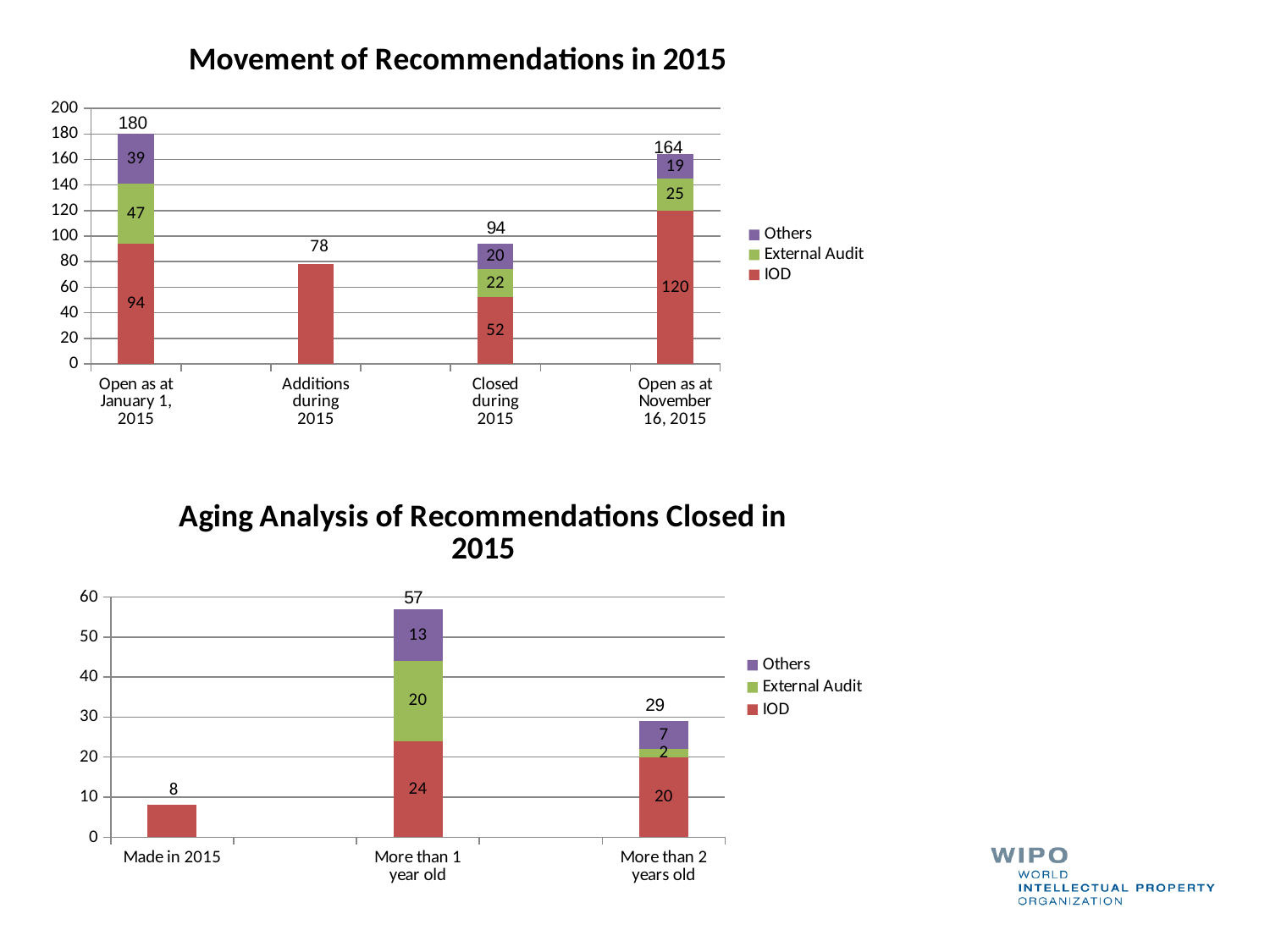
In the 'Movement of Recommendations in 2015' chart, which category has the highest total? Open as at January 1, 2015 In the 'Movement of Recommendations in 2015' chart, what is the IOD value for 'Open as at January 1, 2015'? 94 In the 'Movement of Recommendations in 2015' chart, what is the External Audit value for 'Closed during 2015'? 22 In the 'Aging Analysis of Recommendations Closed in 2015' chart, which category has the lowest total? Made in 2015 What kind of chart is the 'Aging Analysis of Recommendations Closed in 2015' chart? Stacked bar chart In the 'Movement of Recommendations in 2015' chart, what is the difference between the totals for 'Open as at January 1, 2015' and 'Open as at November 16, 2015'? 16 In the 'Movement of Recommendations in 2015' chart, what is the total of the 'Open as at November 16, 2015' bar? 164 In the 'Movement of Recommendations in 2015' chart, is the total for 'Additions during 2015' greater or less than 80? less In the 'Aging Analysis of Recommendations Closed in 2015' chart, what is the External Audit value for 'More than 1 year old'? 20 In the 'Aging Analysis of Recommendations Closed in 2015' chart, what is the difference between the totals for 'More than 1 year old' and 'More than 2 years old'? 28 In the 'Movement of Recommendations in 2015' chart, how many series does the legend list? 3 In the 'Aging Analysis of Recommendations Closed in 2015' chart, how many categories are shown on the x axis? 3